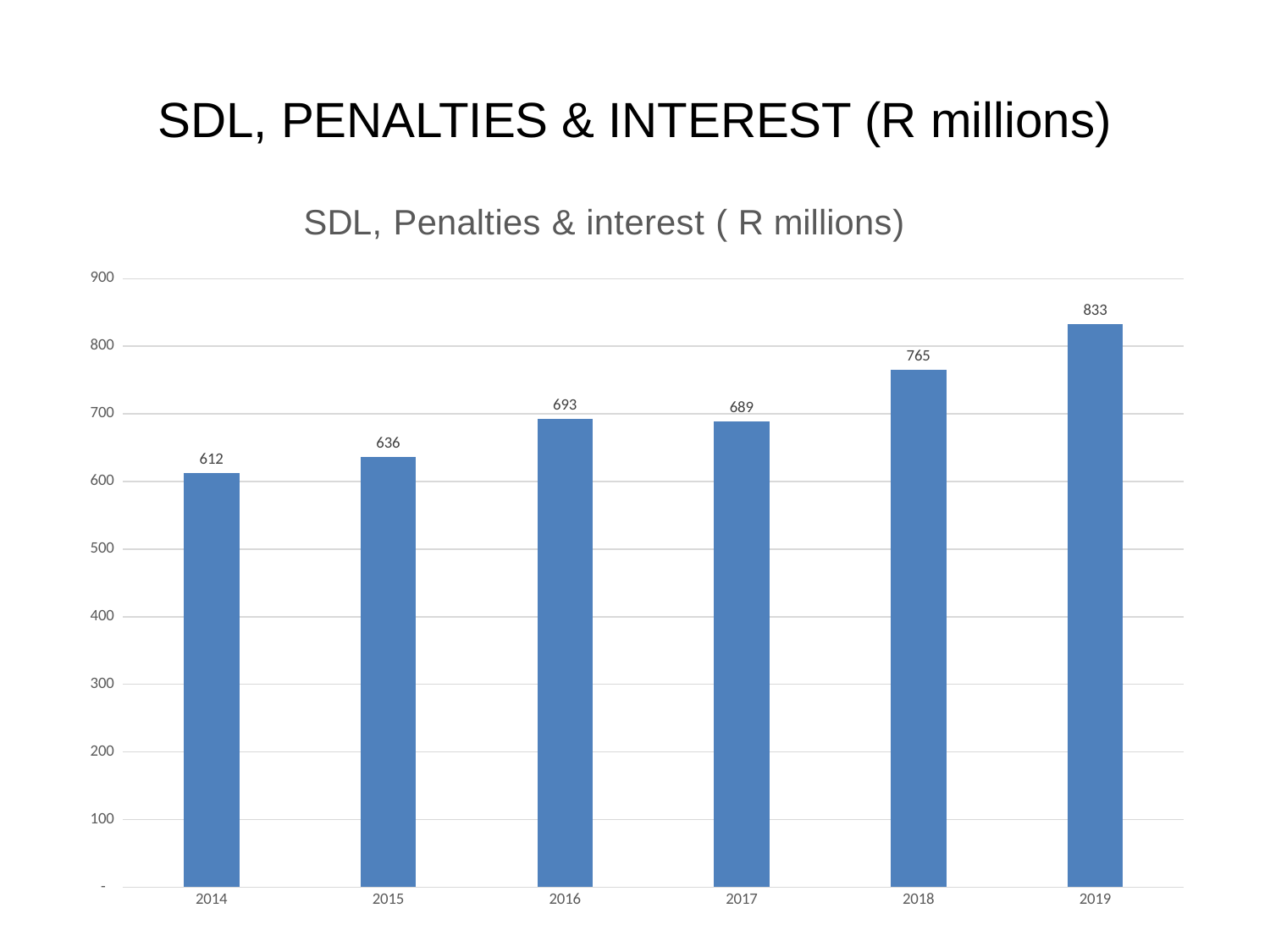
What is the value for 2017? 689 Which year has the lowest value? 2014 What kind of chart is shown on the slide? bar chart What is the value for 2014? 612 How many years are shown on the x axis? 6 What is the title of the chart? SDL, Penalties & interest ( R millions) What is the difference between the values for 2016 and 2014? 81 What is the difference between the values for 2019 and 2018? 68 Is the value for 2018 greater or less than 700? greater What is the value for 2019? 833 Which year has the highest value? 2019 Which is larger, the value for 2015 or the value for 2018? 2018